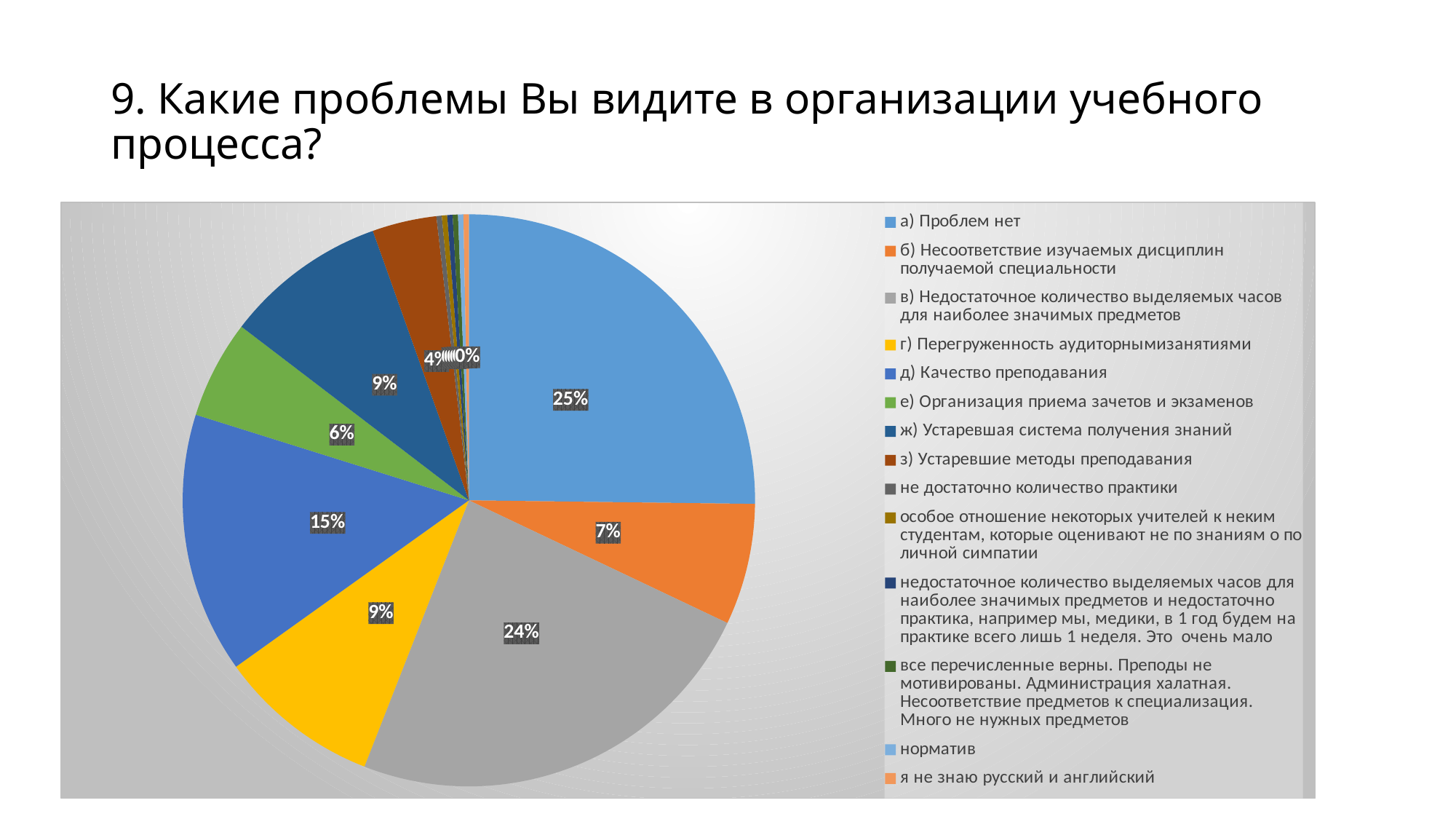
What percentage is shown for "в) Недостаточное количество выделяемых часов для наиболее значимых предметов"? 24% Which category has the largest slice of the pie? а) Проблем нет What percentage is shown for "б) Несоответствие изучаемых дисциплин получаемой специальности"? 7% Which is larger: the slice for "д) Качество преподавания" or the slice for "г) Перегруженность аудиторными занятиями"? д) Качество преподавания What percentage is shown for "д) Качество преподавания"? 15% What percentage is shown for "з) Устаревшие методы преподавания"? 4% What percentage is shown for "е) Организация приема зачетов и экзаменов"? 6% What is the difference in percentage points between "а) Проблем нет" and "б) Несоответствие изучаемых дисциплин получаемой специальности"? 18% What kind of chart is shown on the slide? pie chart What colour is the slice for "г) Перегруженность аудиторными занятиями"? yellow How many entries does the legend list? 14 What share of the pie does "а) Проблем нет" take? 25%